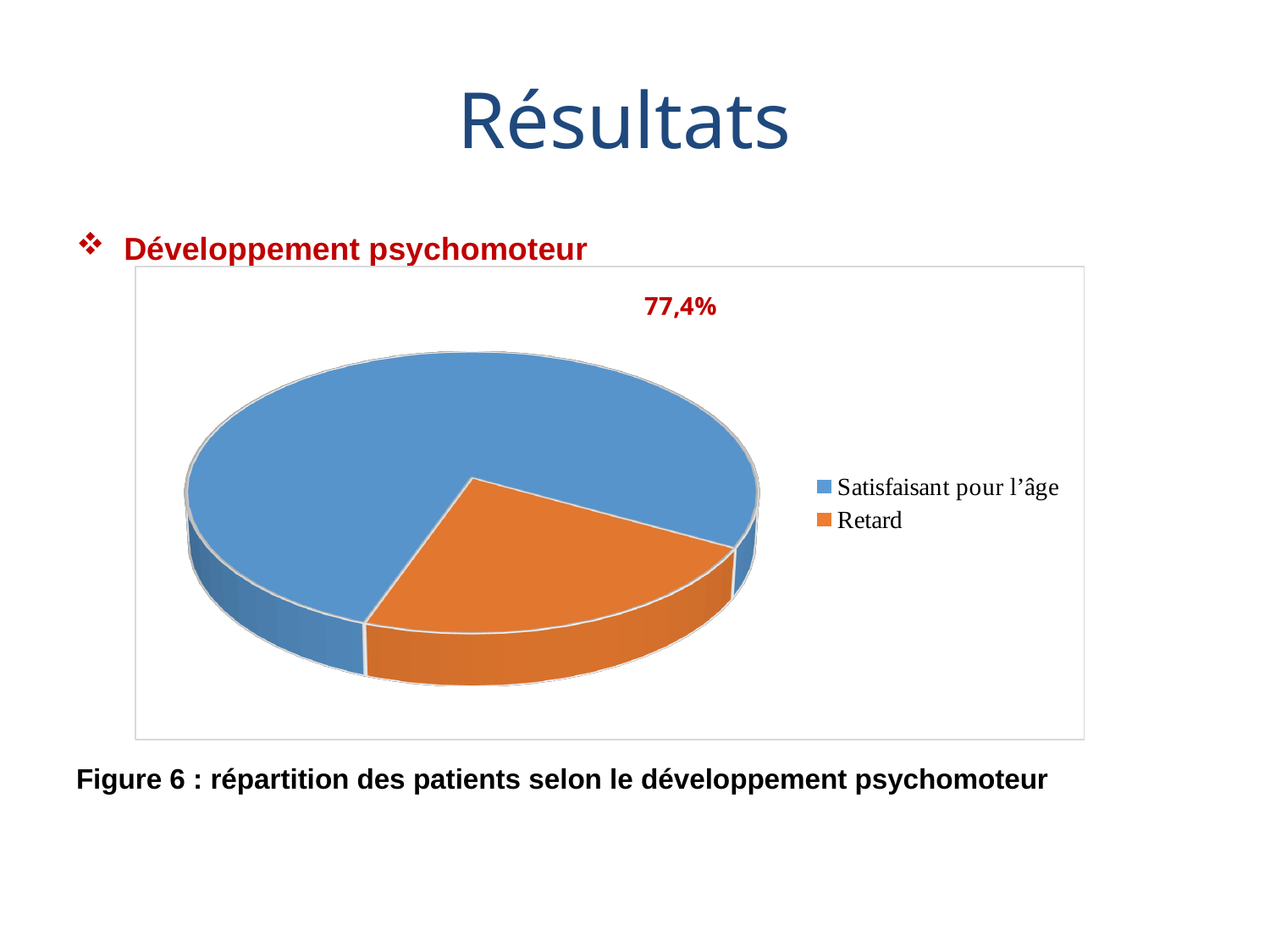
What colour is the 'Retard' slice? orange Which category has the largest slice of the pie? Satisfaisant pour l'âge What are the two legend entries of the pie chart? Satisfaisant pour l'âge; Retard What kind of chart is shown on the slide? pie chart What percentage is shown for the 'Satisfaisant pour l'âge' slice? 77,4% How many categories does the pie chart show? 2 Which is larger, the 'Satisfaisant pour l'âge' slice or the 'Retard' slice? Satisfaisant pour l'âge Which category has the smallest slice of the pie? Retard What share of the pie does 'Satisfaisant pour l'âge' represent? 77,4%